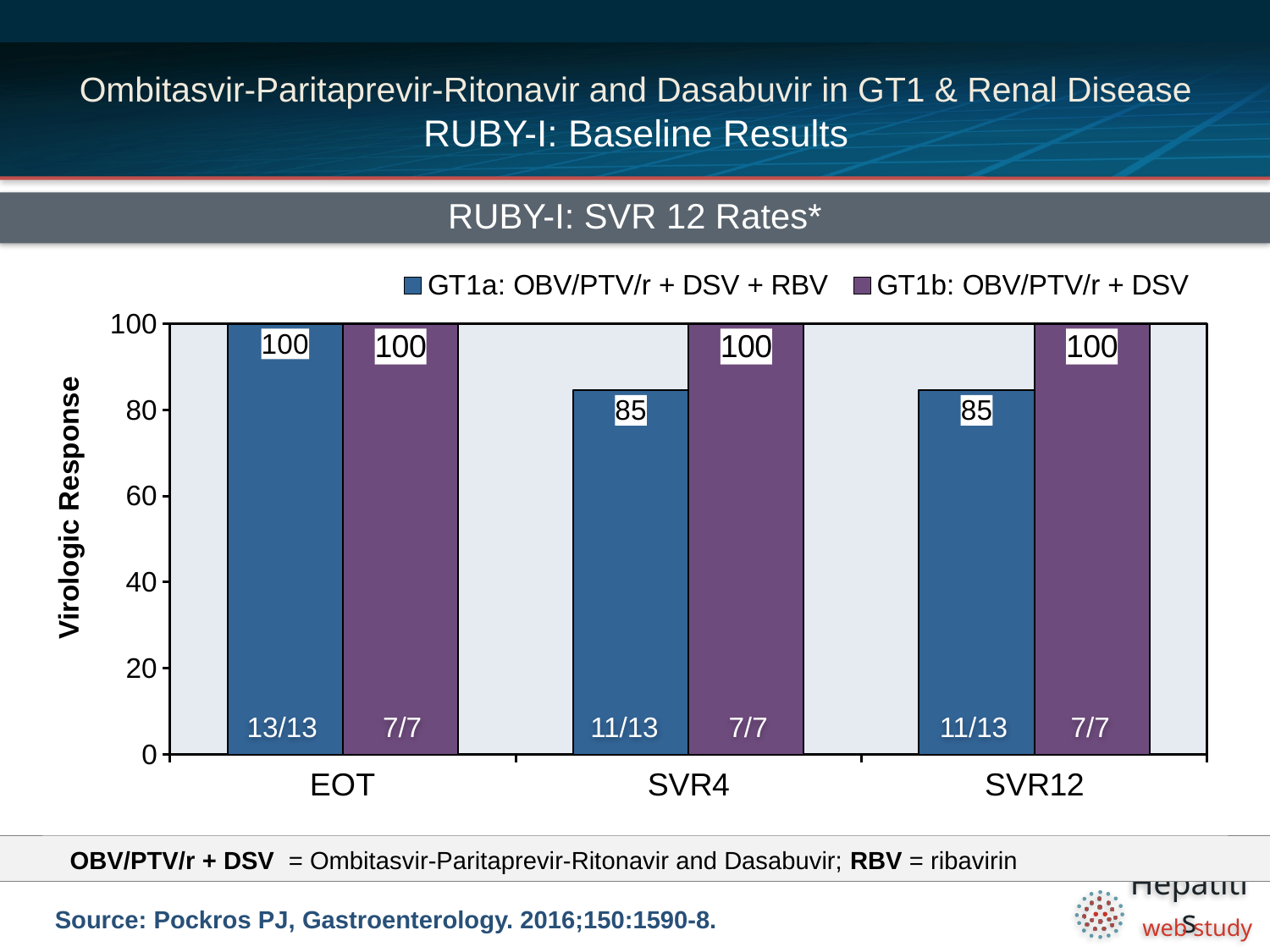
Does the value for GT1a: OBV/PTV/r + DSV + RBV rise or fall from EOT to SVR4? fall How many categories are shown on the x axis? 3 What is the title of the chart? RUBY-I: SVR 12 Rates* What is the value for GT1a: OBV/PTV/r + DSV + RBV at SVR12? 85 What is the value for GT1b: OBV/PTV/r + DSV at SVR4? 100 How many series does the legend list? 2 What is the value for GT1a: OBV/PTV/r + DSV + RBV at EOT? 100 What kind of chart is shown? bar chart What is the difference between the GT1b and GT1a values at SVR12? 15 At SVR4, which series has the larger value, GT1a: OBV/PTV/r + DSV + RBV or GT1b: OBV/PTV/r + DSV? GT1b: OBV/PTV/r + DSV What fraction of patients is shown for GT1b: OBV/PTV/r + DSV at SVR12? 7/7 What fraction of patients is shown for GT1a: OBV/PTV/r + DSV + RBV at SVR4? 11/13